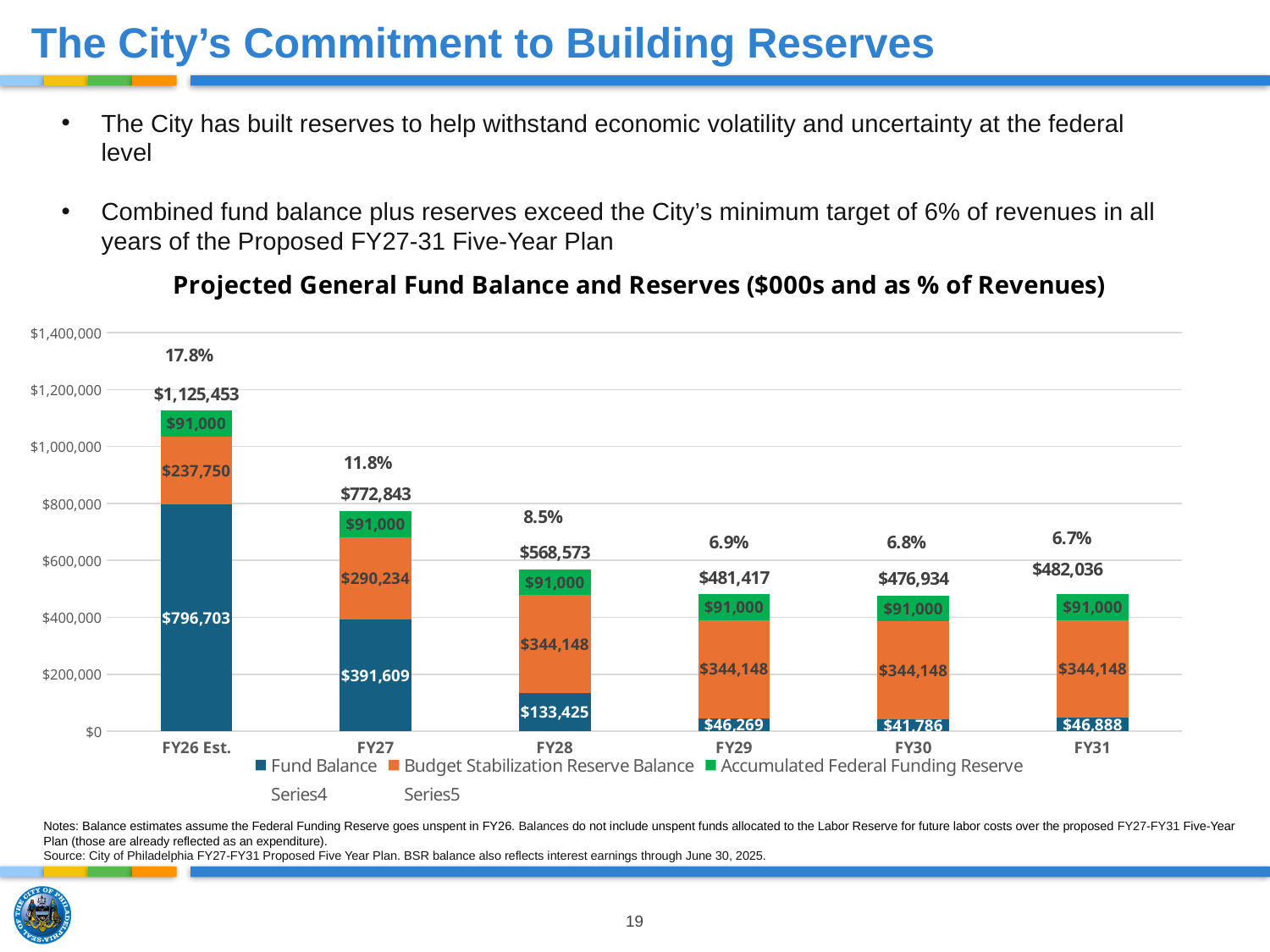
What percentage of revenues is shown for FY29? 6.9% What is the difference between the total combined balance for FY26 Est. and FY27? $352,610 What is the Accumulated Federal Funding Reserve value for FY31? $91,000 What is the total combined balance shown above the FY28 bar? $568,573 What is the Fund Balance value for FY26 Est.? $796,703 How many fiscal years are shown on the x axis? 6 Which is larger, the Fund Balance for FY27 or the Fund Balance for FY28? FY27 What is the Budget Stabilization Reserve Balance for FY27? $290,234 Do the percentage-of-revenues labels rise or fall from FY26 Est. to FY31? Fall Which fiscal year has the highest total combined balance? FY26 Est. What kind of chart is shown on the slide? Stacked bar chart Is the total combined balance for FY30 greater or less than $600,000? less